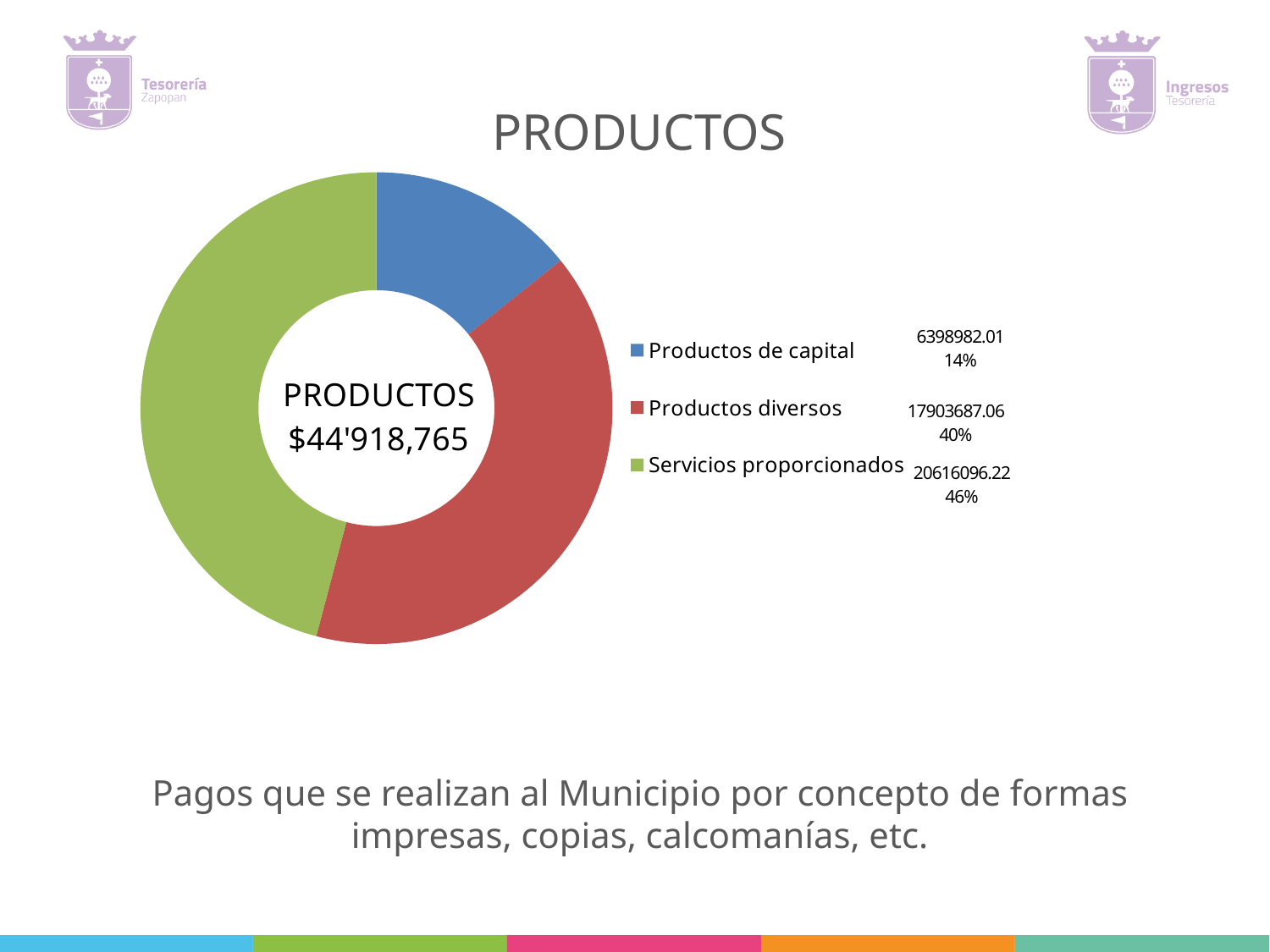
What share of the chart does Servicios proporcionados represent? 46% What share of the chart does Productos de capital represent? 14% Which is larger, Productos diversos or Productos de capital? Productos diversos What is the value for Productos diversos? 17903687.06 Which category has the largest value? Servicios proporcionados What colour represents Productos diversos in the chart? Red Which category has the smallest value? Productos de capital How many categories does the chart show? 3 What total amount is shown in the center of the doughnut chart? $44'918,765 What is the value for Productos de capital? 6398982.01 What kind of chart is shown on the slide? Doughnut chart What is the value for Servicios proporcionados? 20616096.22